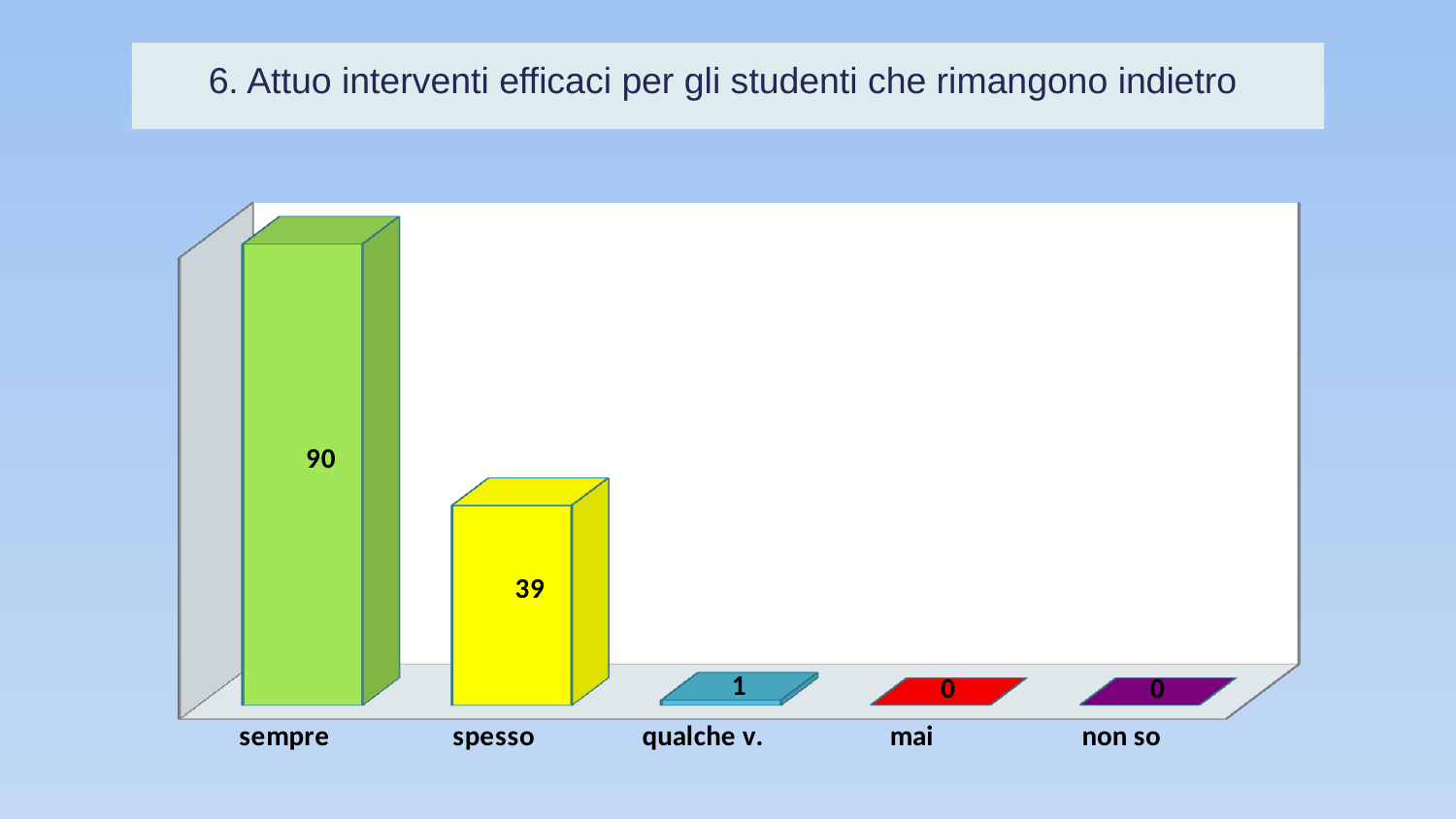
Which is larger, the value for "spesso" or the value for "qualche v."? spesso What is the value for "mai"? 0 What is the total of the values for "sempre", "spesso" and "qualche v."? 130 Which category has the highest value? sempre What is the value for "spesso"? 39 What is the value for "qualche v."? 1 Do the values rise or fall from left to right along the x axis? fall What is the difference between the values for "sempre" and "spesso"? 51 How many categories are shown on the x axis? 5 What kind of chart is shown on the slide? bar chart What is the value for "sempre"? 90 What is the title of the slide above the chart? 6. Attuo interventi efficaci per gli studenti che rimangono indietro